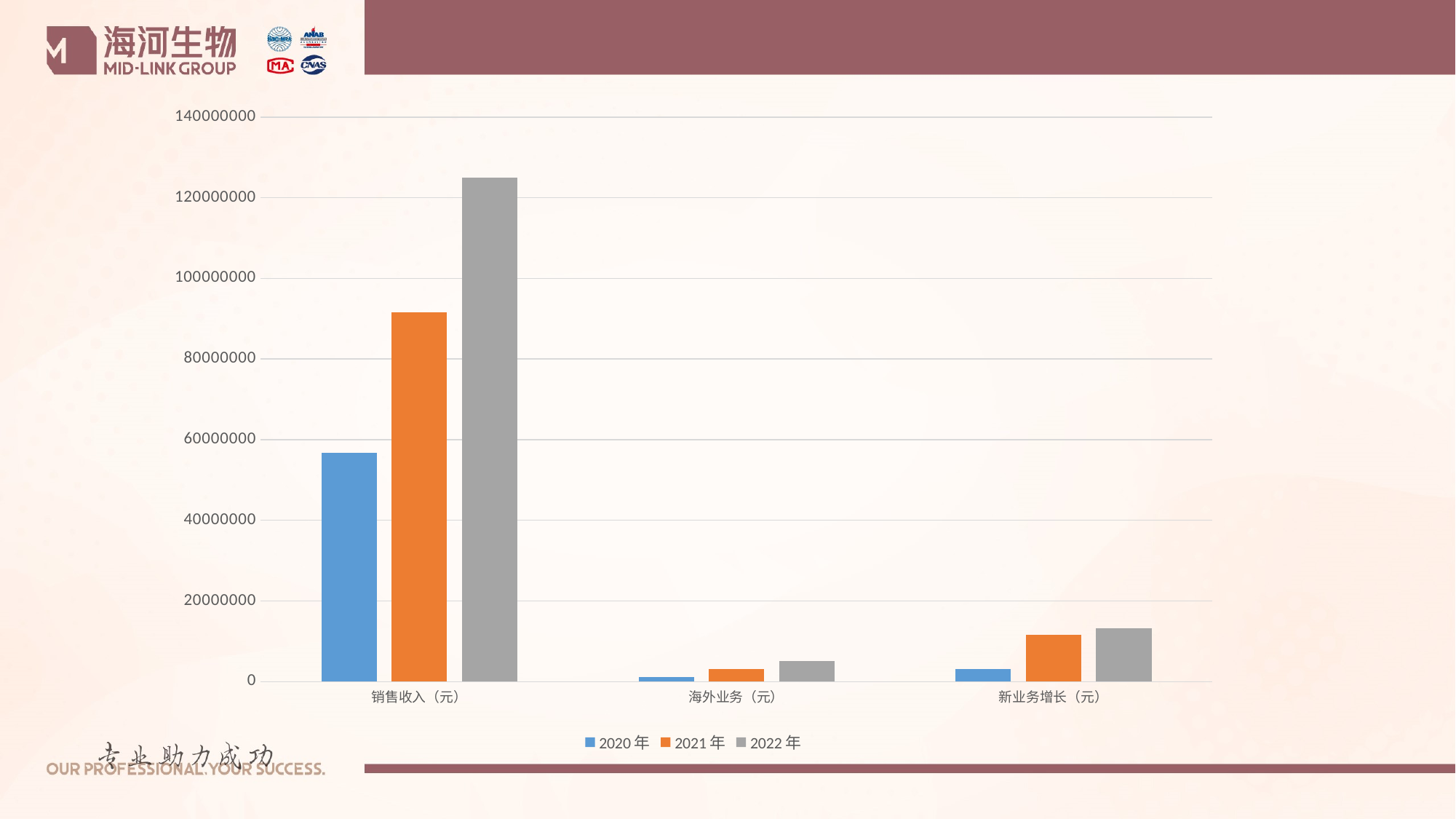
For 销售收入（元）, do the values rise or fall from 2020 年 to 2022 年? rise Is the 2020 年 value for 销售收入（元） greater or less than 40000000? greater Is the 2021 年 value for 销售收入（元） greater or less than 100000000? less How many series does the chart's legend list? 3 Is the 2022 年 value for 销售收入（元） greater or less than 120000000? greater How many categories are shown on the x axis of the chart? 3 Which series has the highest value for 销售收入（元）? 2022 年 Which category has the lowest value for the 2020 年 series? 海外业务（元） What colour are the bars for the 2021 年 series? orange For 销售收入（元）, which is larger: the 2020 年 value or the 2021 年 value? 2021 年 What kind of chart is shown on the slide? bar chart